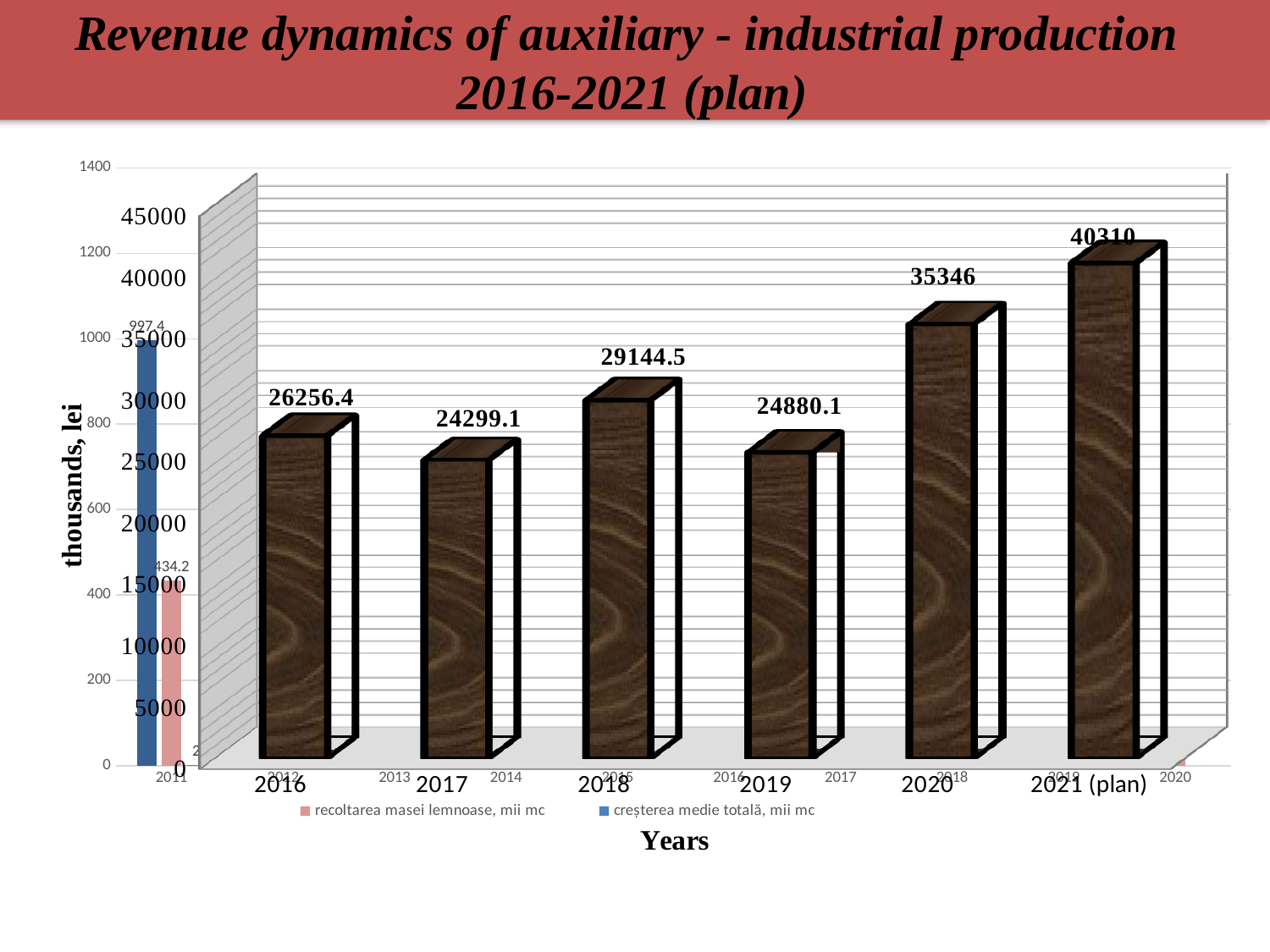
What kind of chart is shown on the slide? bar chart By how much does the 2021 (plan) value exceed the 2020 value? 4964 Which is larger, the revenue value for 2016 or for 2019? 2016 What is the revenue value for 2016? 26256.4 What is the difference between the revenue values for 2020 and 2019? 10465.9 Is the value for 2020 greater or less than 30000? greater What is the planned revenue value for 2021 (plan)? 40310 What is the revenue value for 2018? 29144.5 Which year has the highest revenue value? 2021 (plan) What is the label of the vertical axis? thousands, lei How many years are shown as bars in the chart? 6 Which year has the lowest revenue value? 2017